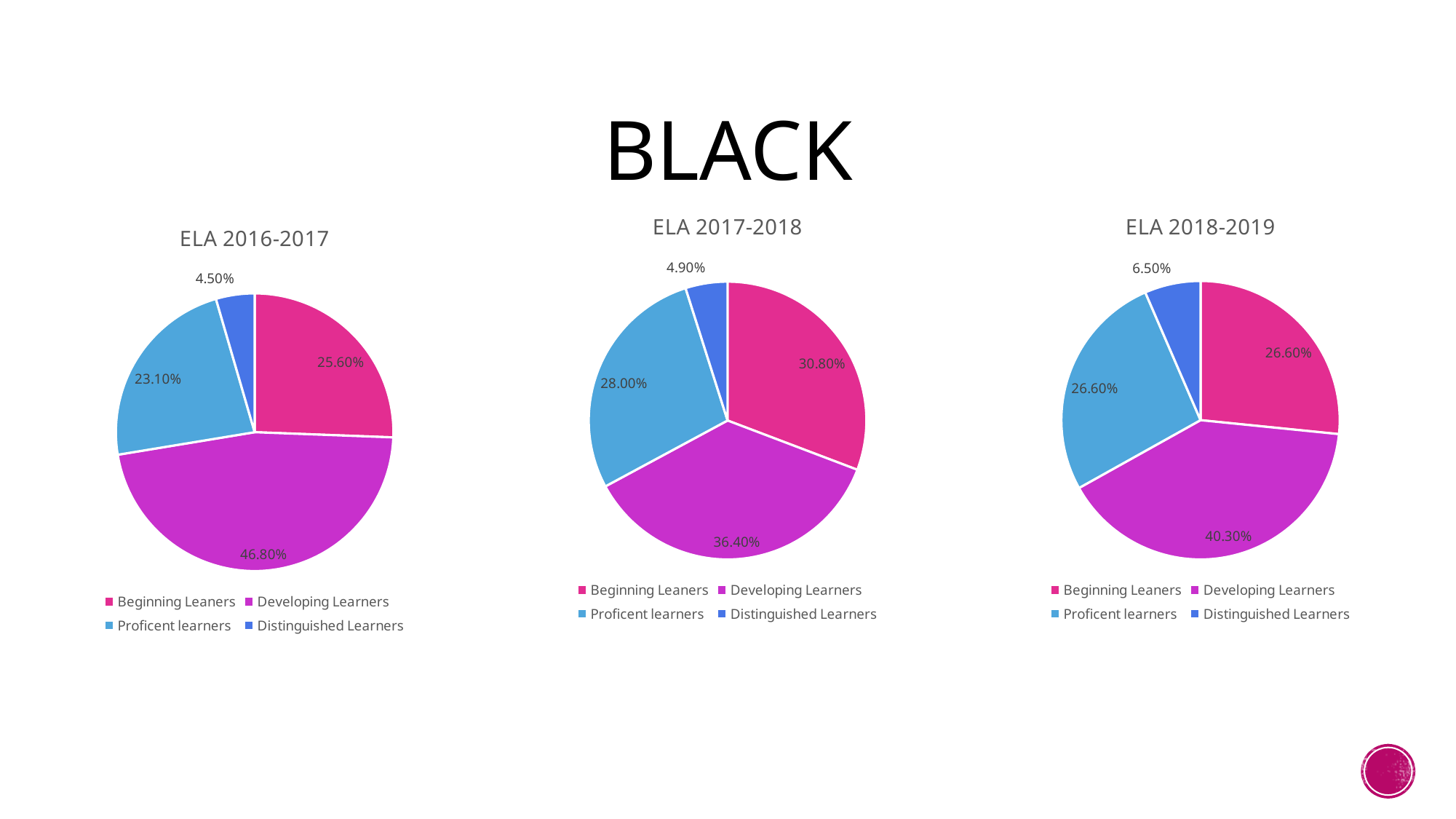
What is the title of the chart on the right of the slide? ELA 2018-2019 In the ELA 2017-2018 chart, which category has the largest slice? Developing Learners In the ELA 2016-2017 chart, which category has the smallest slice? Distinguished Learners How many entries does the legend of the ELA 2016-2017 chart list? 4 In the ELA 2016-2017 chart, what share do Developing Learners have? 46.80% In the ELA 2018-2019 chart, what is the value for Distinguished Learners? 6.50% In the ELA 2017-2018 chart, which is larger: Beginning Leaners or Proficent learners? Beginning Leaners In the ELA 2018-2019 chart, what is the difference between Developing Learners and Beginning Leaners? 13.70% How many slices does the ELA 2018-2019 pie chart have? 4 In the ELA 2016-2017 chart, what is the difference between Beginning Leaners and Proficent learners? 2.50% In the ELA 2017-2018 chart, what is the value for Proficent learners? 28.00% What type of chart is the ELA 2017-2018 chart? Pie chart